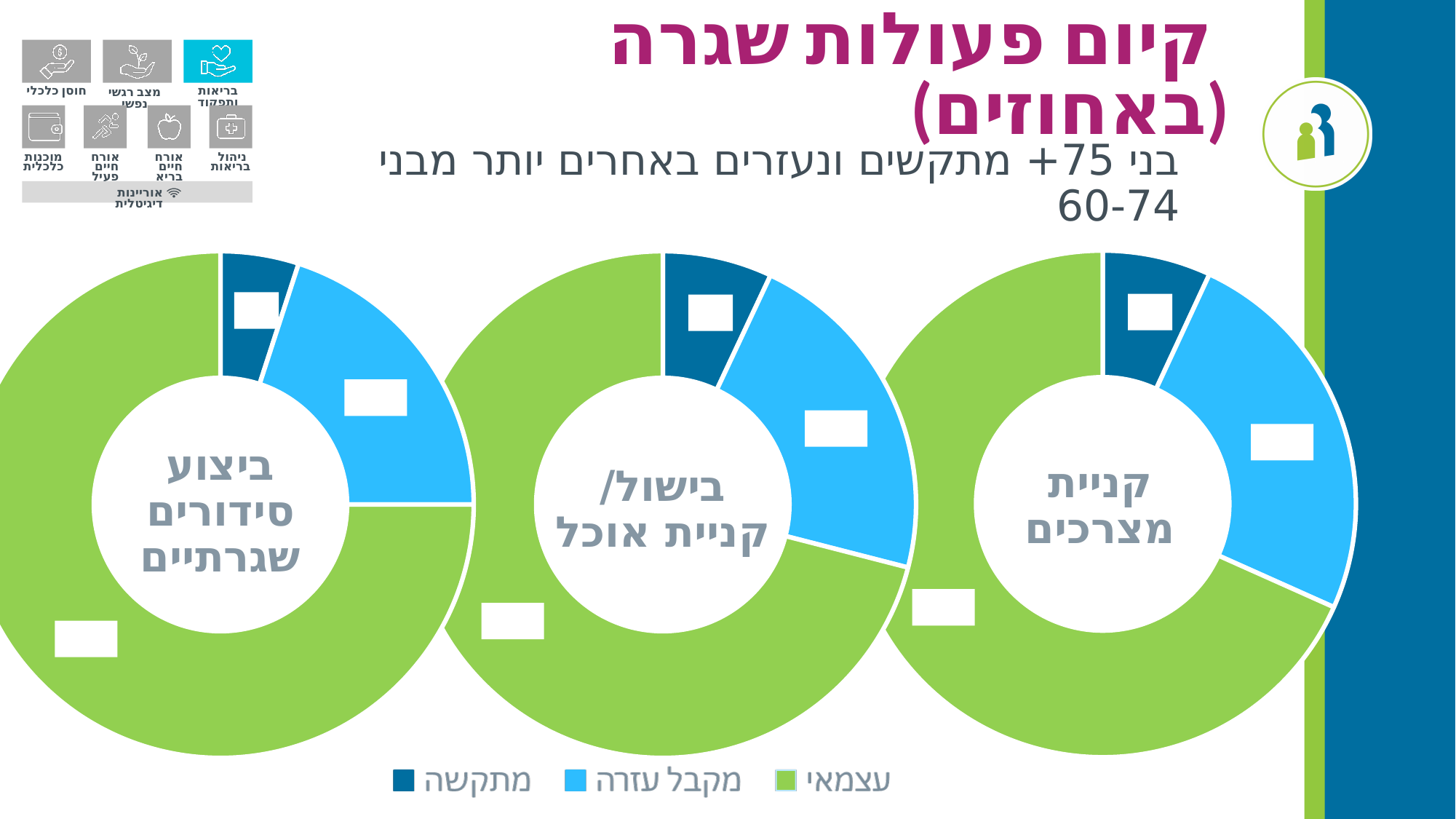
In the chart titled 'בישול/קניית אוכל', which category has the smallest slice? מתקשה In the chart titled 'ביצוע סידורים שגרתיים', which category has the smallest slice? מתקשה In the chart titled 'קניית מצרכים', which category has the smallest slice? מתקשה How many donut charts are shown on the slide? 3 Which colour represents 'מקבל עזרה' in the legend? Light blue What kind of chart is used for the three charts on the slide? Pie (donut) chart In the chart titled 'קניית מצרכים', which slice is larger: 'מקבל עזרה' or 'מתקשה'? מקבל עזרה How many series does the legend at the bottom of the slide list? 3 What is the title of the rightmost donut chart? קניית מצרכים In the chart titled 'קניית מצרכים', which category has the largest slice? עצמאי In the chart titled 'ביצוע סידורים שגרתיים', which category has the largest slice? עצמאי In the chart titled 'בישול/קניית אוכל', which category has the largest slice? עצמאי